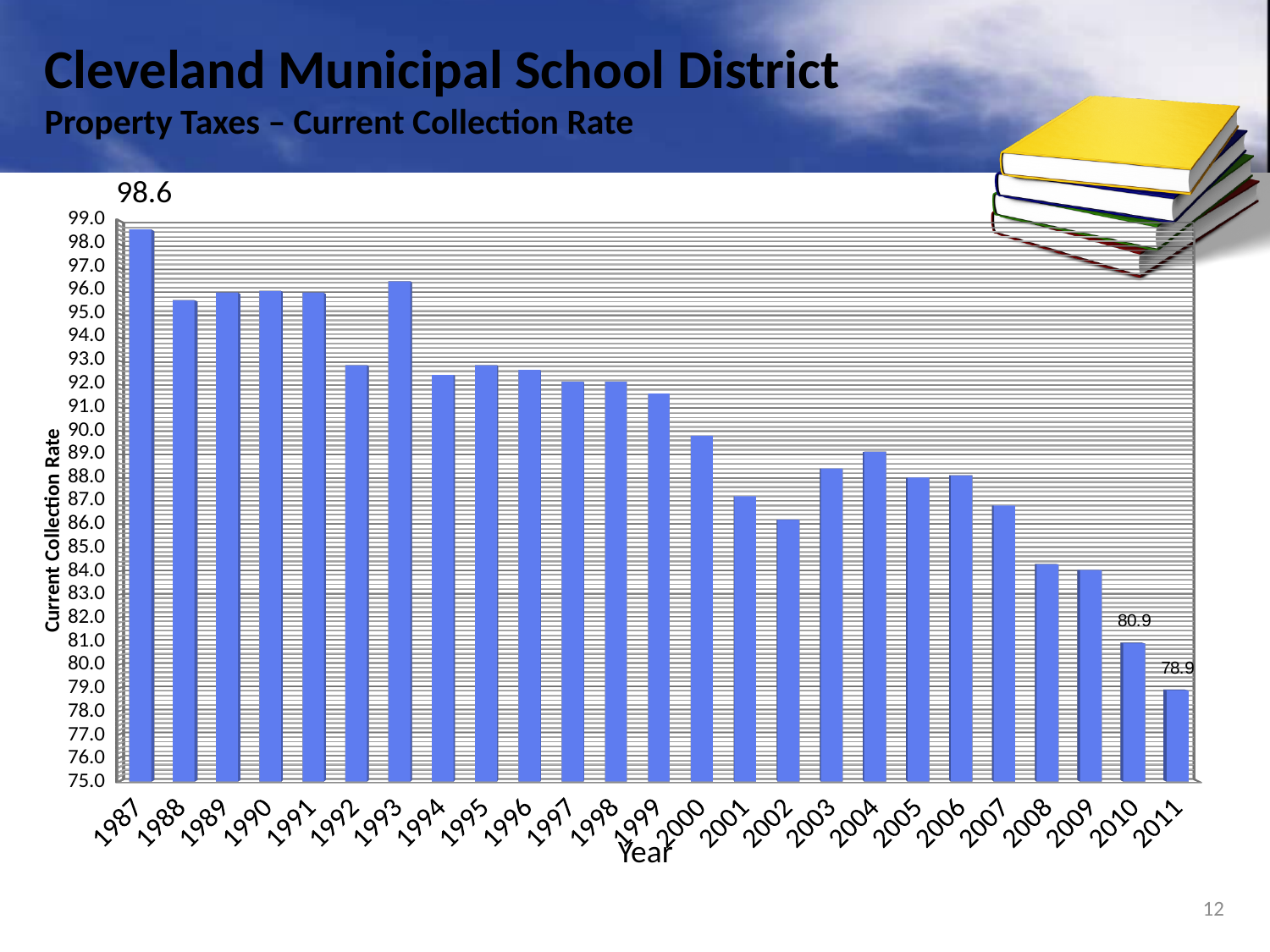
Which year has the lowest current collection rate? 2011 What is the difference between the collection rates for 1987 and 2011? 19.7 What is the current collection rate for 2011? 78.9 How many years are shown on the x axis? 25 Which year has the highest current collection rate? 1987 Which year has a higher collection rate, 1992 or 1993? 1993 What is the current collection rate for 2010? 80.9 Is the collection rate for 1999 greater or less than 90.0? greater What kind of chart is shown on the slide? bar chart Is the collection rate for 2008 greater or less than 85.0? less What is the current collection rate for 1987? 98.6 What is the difference between the collection rates for 2010 and 2011? 2.0